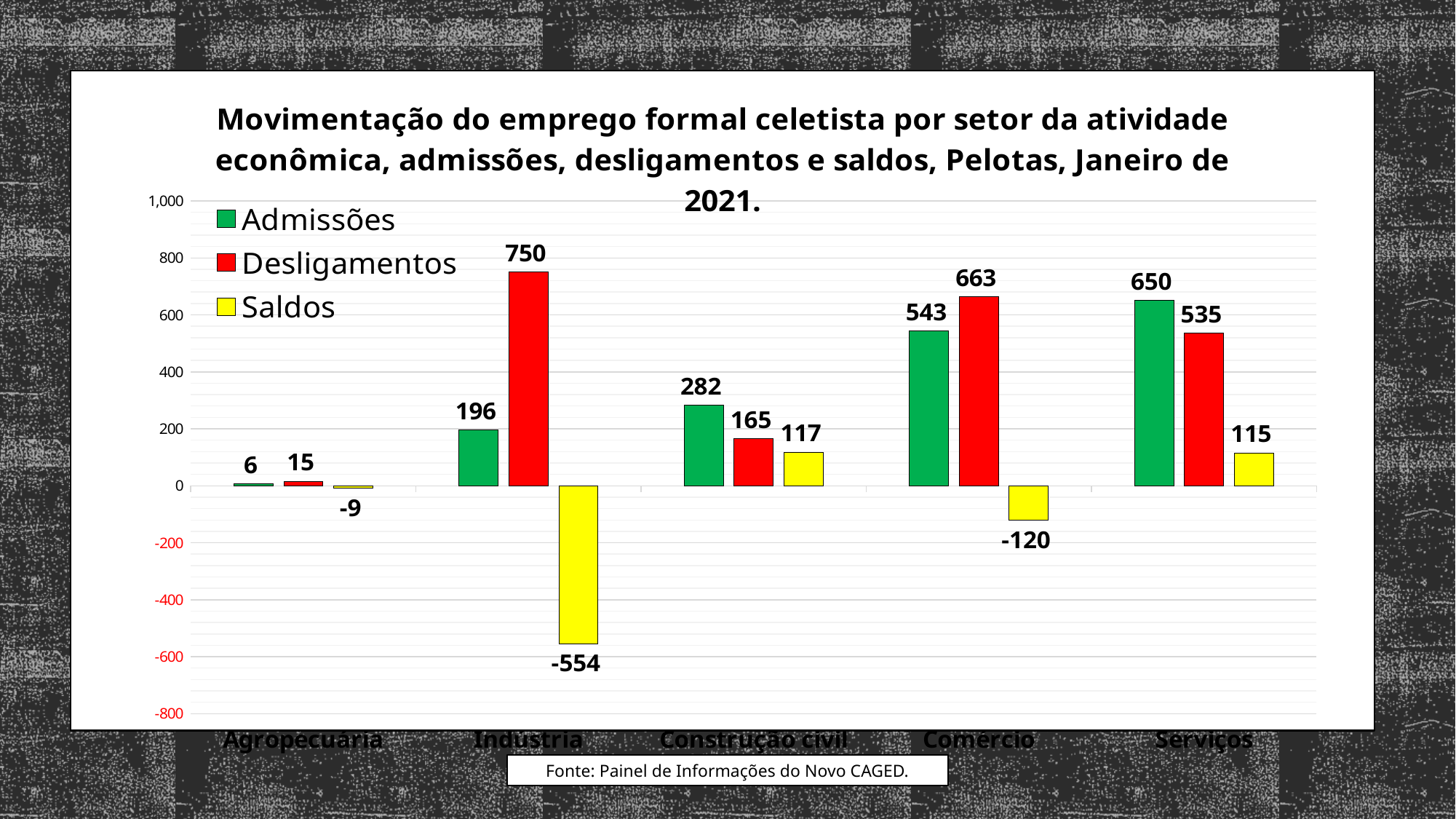
What is the Desligamentos value for Comércio? 663 What is the Saldos value for Indústria? -554 Which is larger for Serviços, Admissões or Desligamentos? Admissões How many sectors are shown on the x axis? 5 What is the difference between Desligamentos and Admissões for Indústria? 554 Which colour represents the Saldos series? Yellow What is the Admissões value for Indústria? 196 Which sector has the highest Admissões value? Serviços What is the Saldos value for Construção civil? 117 What kind of chart is shown on the slide? Bar chart How many series does the legend list? 3 Which sector has the lowest Saldos value? Indústria